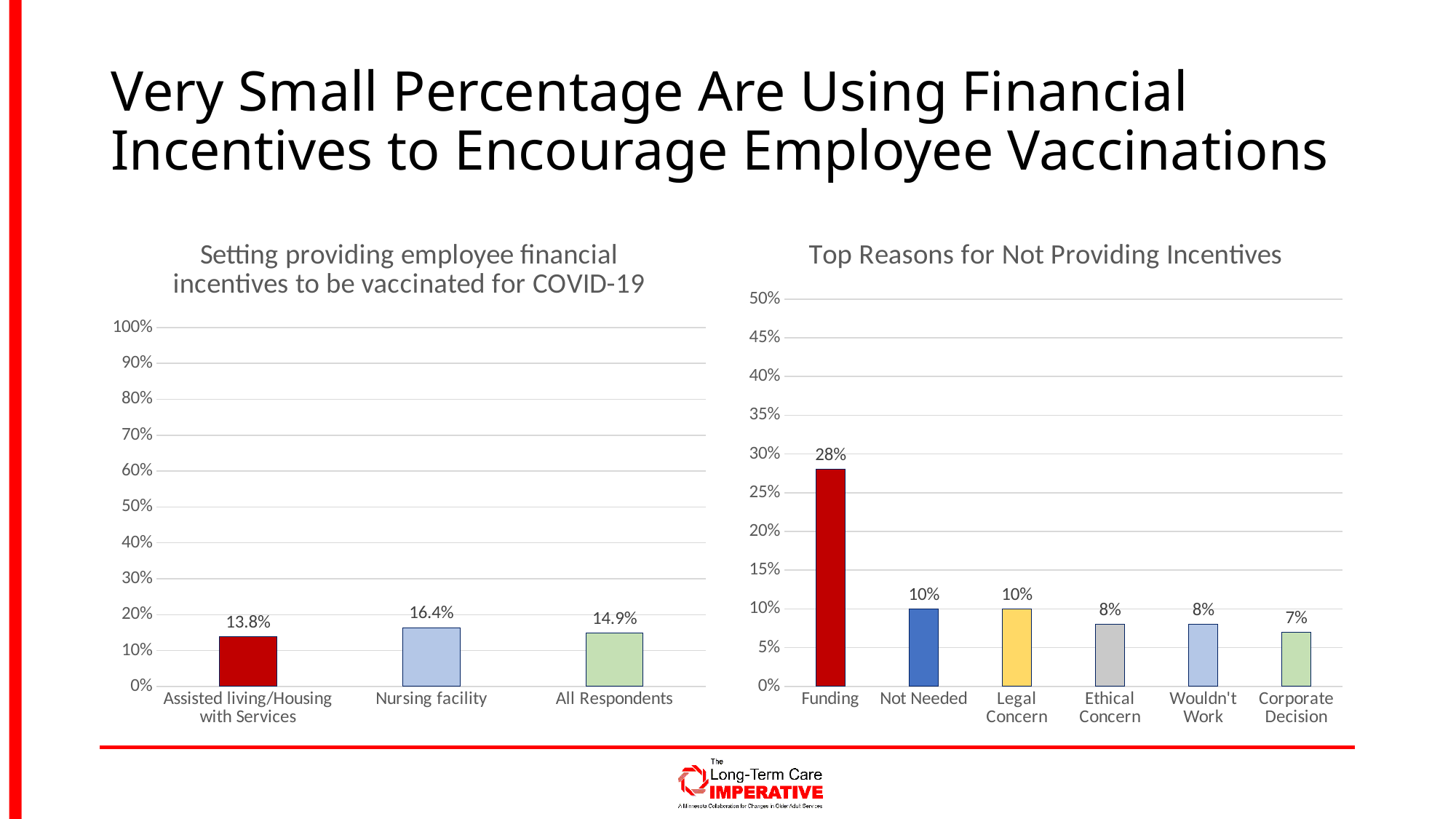
In the left chart (Setting providing employee financial incentives to be vaccinated for COVID-19), what is the difference between Nursing facility and Assisted living/Housing with Services? 2.6% In the right chart (Top Reasons for Not Providing Incentives), what is the difference between Funding and Not Needed? 18% In the left chart (Setting providing employee financial incentives to be vaccinated for COVID-19), what is the value for Nursing facility? 16.4% What type of chart is the right chart (Top Reasons for Not Providing Incentives)? Bar chart In the right chart (Top Reasons for Not Providing Incentives), which reason has the lowest value? Corporate Decision In the left chart (Setting providing employee financial incentives to be vaccinated for COVID-19), which category has the highest value? Nursing facility In the right chart (Top Reasons for Not Providing Incentives), what is the value for Funding? 28% In the right chart (Top Reasons for Not Providing Incentives), how many reasons are shown? 6 In the left chart (Setting providing employee financial incentives to be vaccinated for COVID-19), what is the value for Assisted living/Housing with Services? 13.8% In the right chart (Top Reasons for Not Providing Incentives), which is larger, Legal Concern or Ethical Concern? Legal Concern In the left chart (Setting providing employee financial incentives to be vaccinated for COVID-19), how many categories are shown? 3 In the right chart (Top Reasons for Not Providing Incentives), what is the value for Corporate Decision? 7%